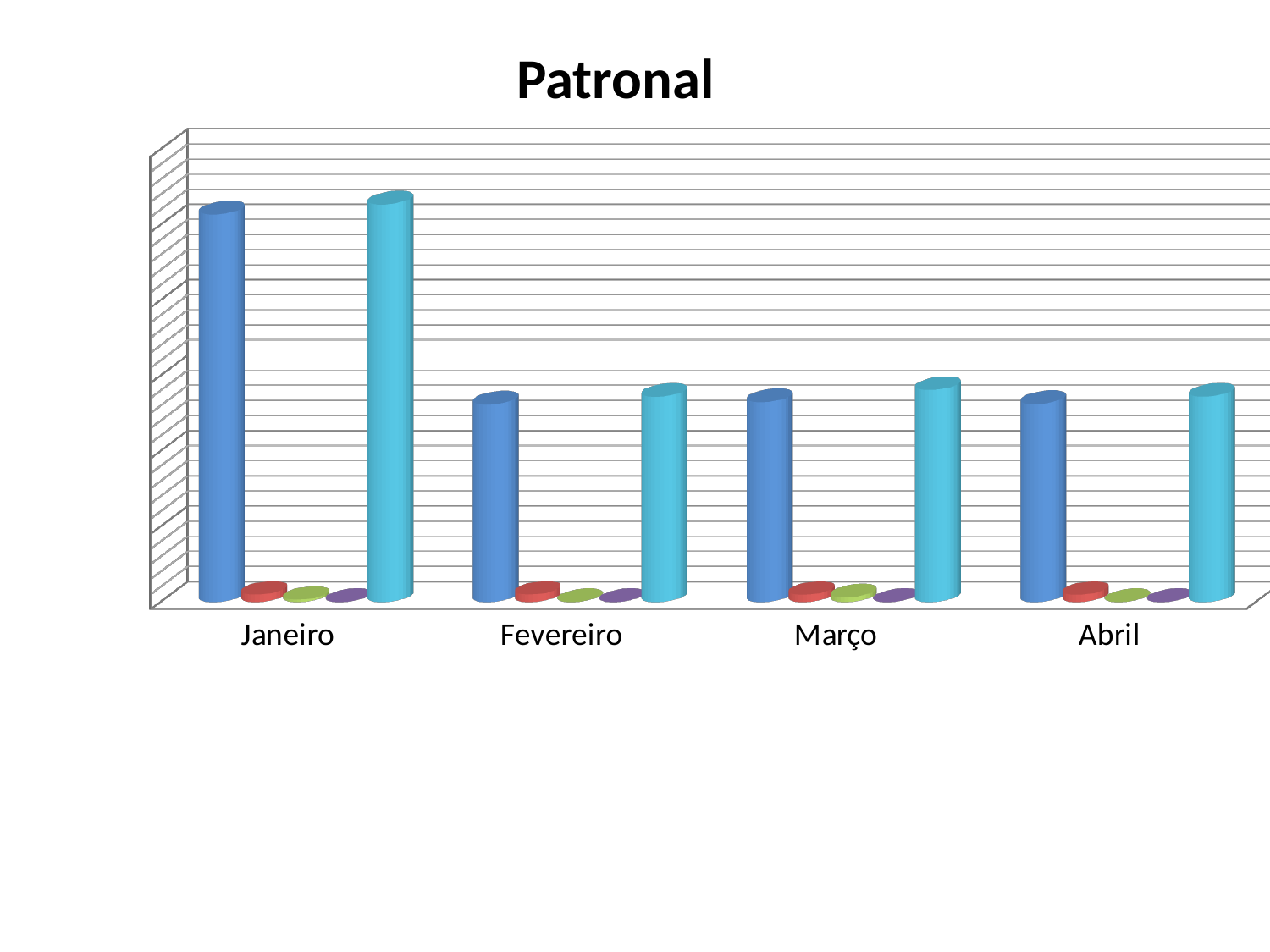
What kind of chart is shown on the slide? bar chart What is the title of the chart? Patronal Is the dark blue bar taller for Janeiro or for Fevereiro? Janeiro In which category is the light blue bar the tallest? Janeiro Does the dark blue bar rise or fall from Janeiro to Fevereiro? fall Is the light blue bar taller for Janeiro or for Abril? Janeiro Is the dark blue bar taller for Janeiro or for Março? Janeiro In which category is the dark blue bar the tallest? Janeiro How many categories are shown on the x axis? 4 How many bars are plotted for each category? 5 Which categories are listed on the x axis? Janeiro, Fevereiro, Março, Abril